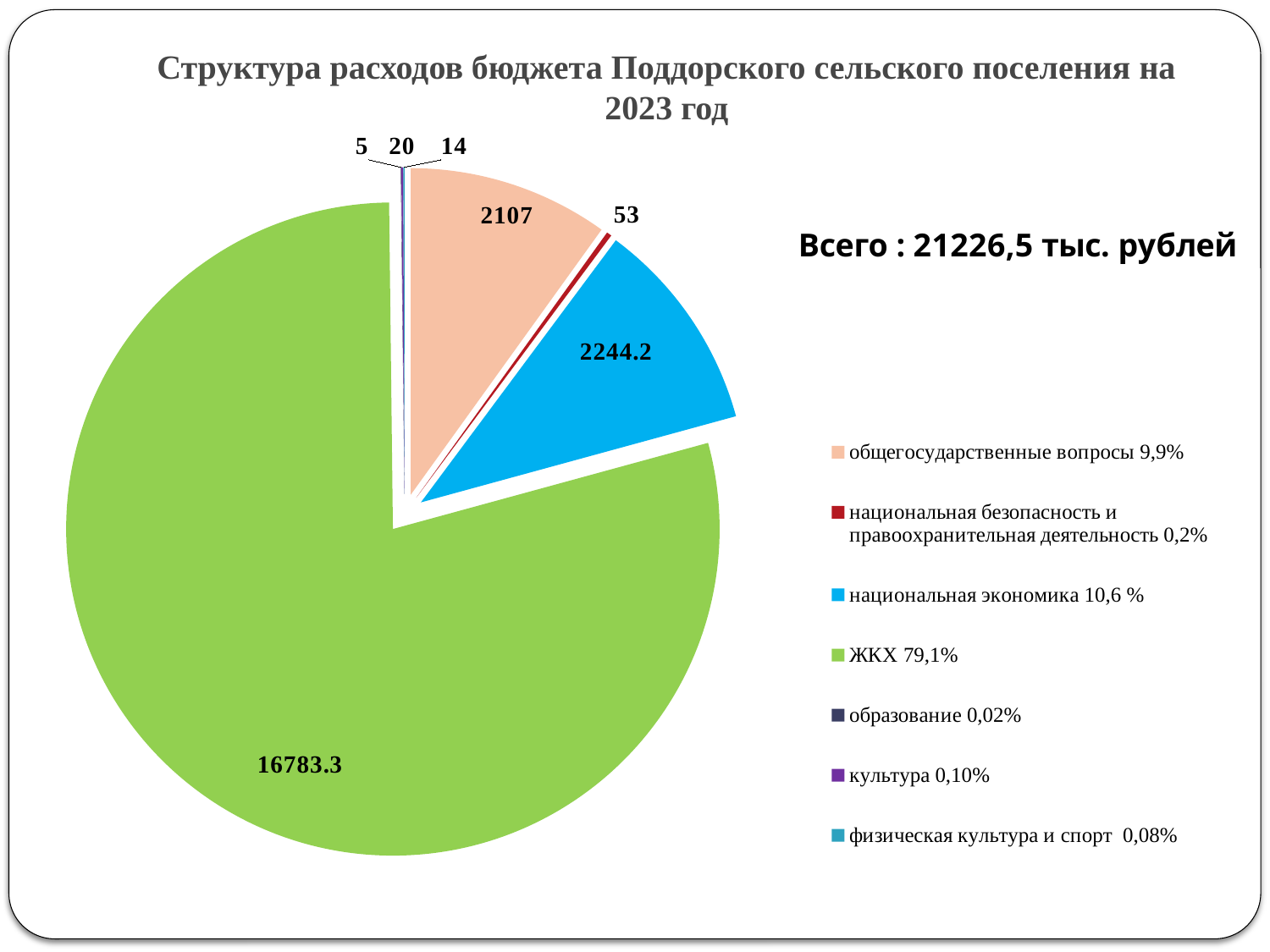
Which is larger: the value for национальная экономика or the value for общегосударственные вопросы? национальная экономика What is the difference between the value for ЖКХ and the value for национальная экономика? 14539.1 What is the value shown for общегосударственные вопросы in the pie chart? 2107 What is the value shown for национальная безопасность и правоохранительная деятельность in the pie chart? 53 What total amount is stated next to the pie chart? 21226,5 тыс. рублей What is the value shown for ЖКХ in the pie chart? 16783.3 What is the value shown for национальная экономика in the pie chart? 2244.2 How many categories does the legend of the pie chart list? 7 What kind of chart is shown on the slide? pie chart What share of the pie does ЖКХ represent, according to the legend? 79,1% Which category has the largest slice of the pie chart? ЖКХ What is the difference between the value for национальная экономика and the value for общегосударственные вопросы? 137.2